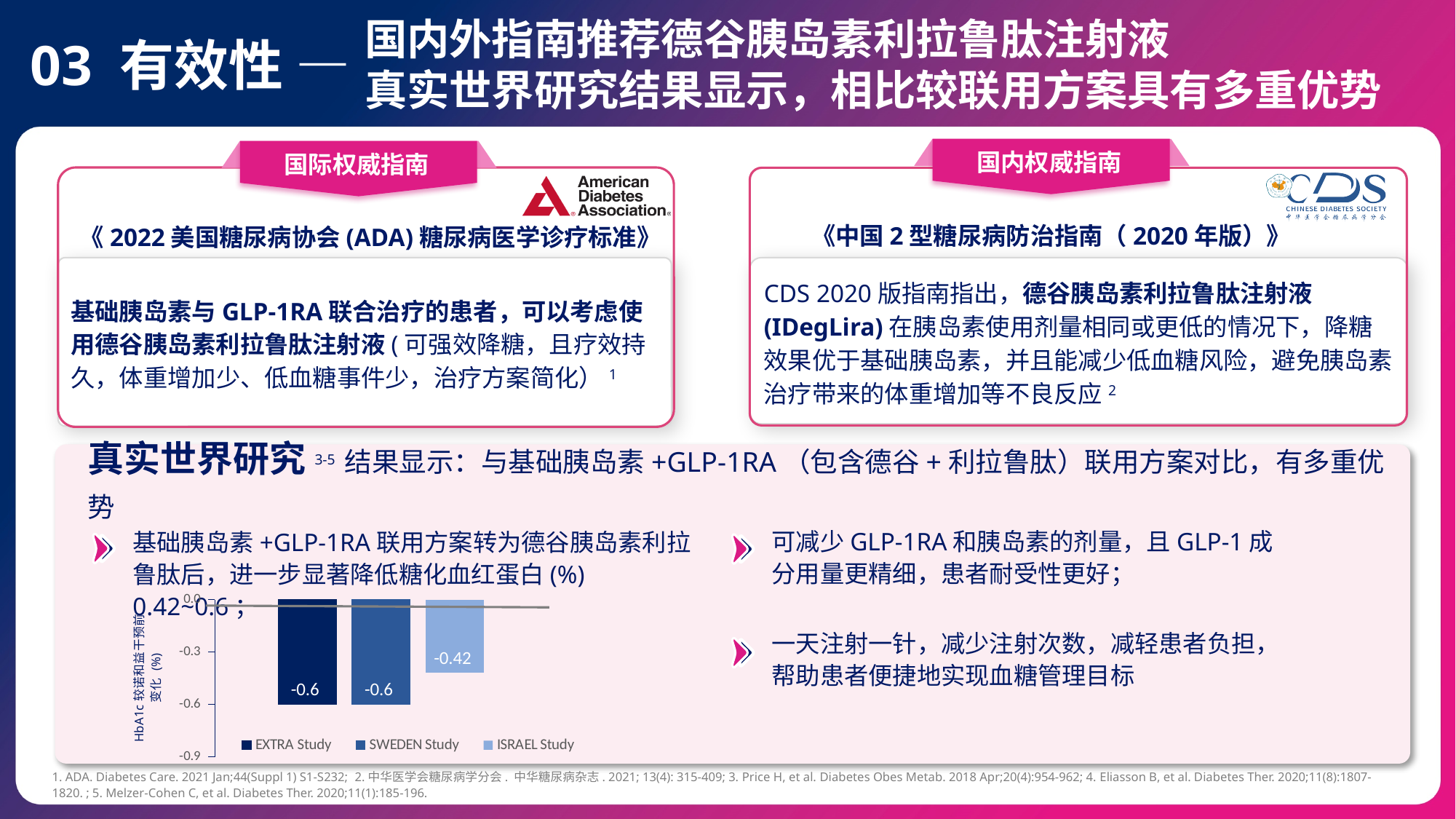
What is the HbA1c change value shown for the ISRAEL Study? -0.42 What is the difference between the ISRAEL Study value and the EXTRA Study value? 0.18 Which bar is shorter, the ISRAEL Study bar or the SWEDEN Study bar? ISRAEL Study Is the value for the ISRAEL Study greater or less than -0.3? less Which study shows the smallest HbA1c reduction (the bar closest to 0.0)? ISRAEL Study What is the lowest tick value shown on the chart's vertical axis? -0.9 What is the HbA1c change value shown for the EXTRA Study? -0.6 What is the HbA1c change value shown for the SWEDEN Study? -0.6 What type of chart is shown at the bottom of the slide? bar chart How many bars are plotted in the chart? 3 How many series does the chart legend list? 3 Which legend entry is shown in the lightest blue colour? ISRAEL Study